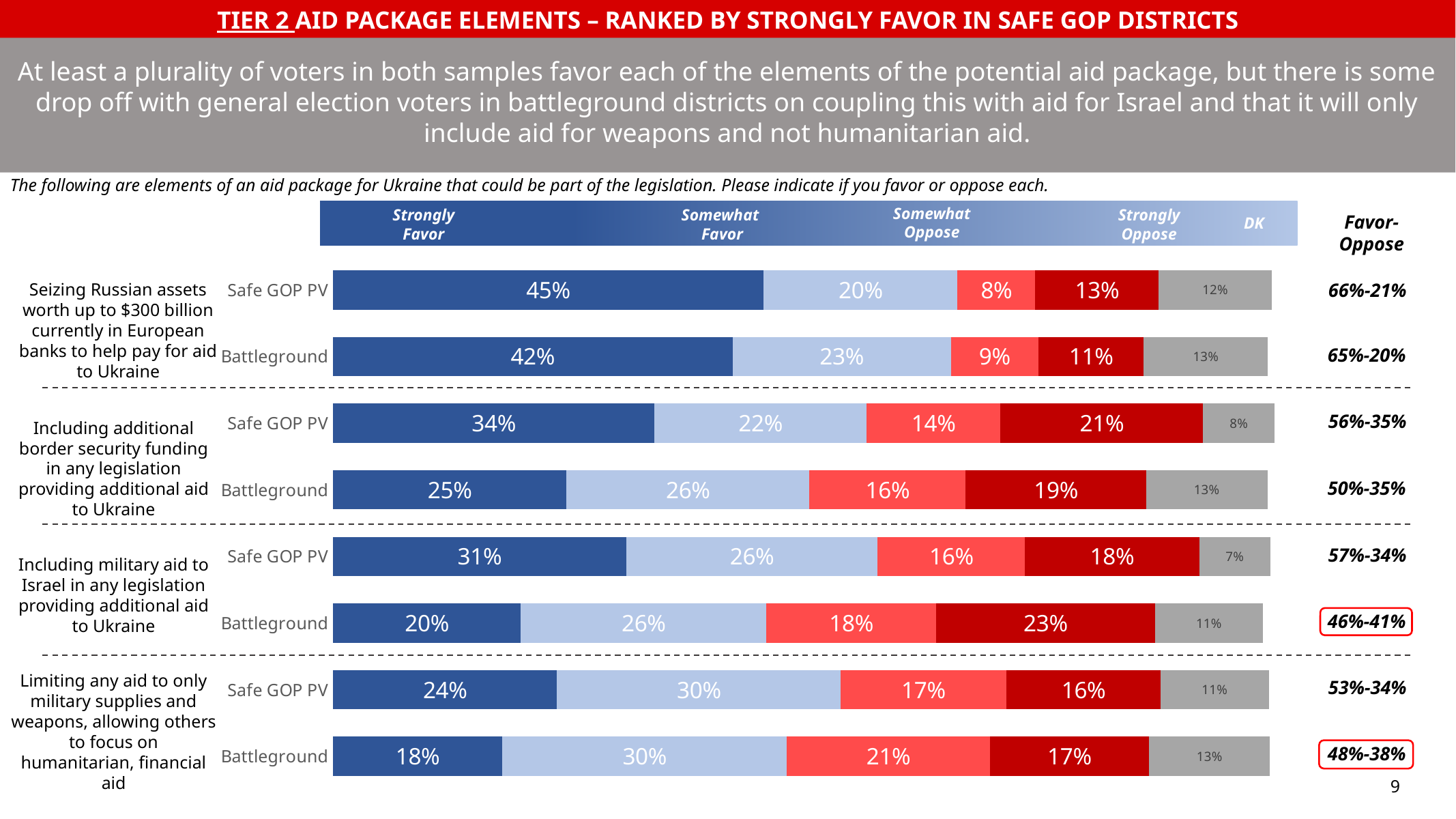
What is the Favor-Oppose figure shown for Battleground voters on limiting any aid to only military supplies and weapons? 48%-38% Which is larger: the Strongly Oppose value for Safe GOP PV voters or for Battleground voters on including additional border security funding? Safe GOP PV What is the Strongly Oppose value for Battleground voters on including military aid to Israel in any legislation providing additional aid to Ukraine? 23% What is the DK value for Safe GOP PV voters on including military aid to Israel in any legislation providing additional aid to Ukraine? 7% Which bar has the highest Strongly Favor value? Safe GOP PV, seizing Russian assets How many bars are plotted in the chart? 8 How many series does the chart legend list? 5 What kind of chart is shown on the slide? Stacked bar chart What is the difference between the Strongly Favor values for Safe GOP PV and Battleground voters on including additional border security funding? 9 percentage points Which bar has the lowest Strongly Favor value? Battleground, limiting any aid to only military supplies and weapons What is the Somewhat Favor value for Battleground voters on including additional border security funding in any legislation providing additional aid to Ukraine? 26% What percentage of Safe GOP PV voters strongly favor seizing Russian assets worth up to $300 billion currently in European banks to help pay for aid to Ukraine? 45%